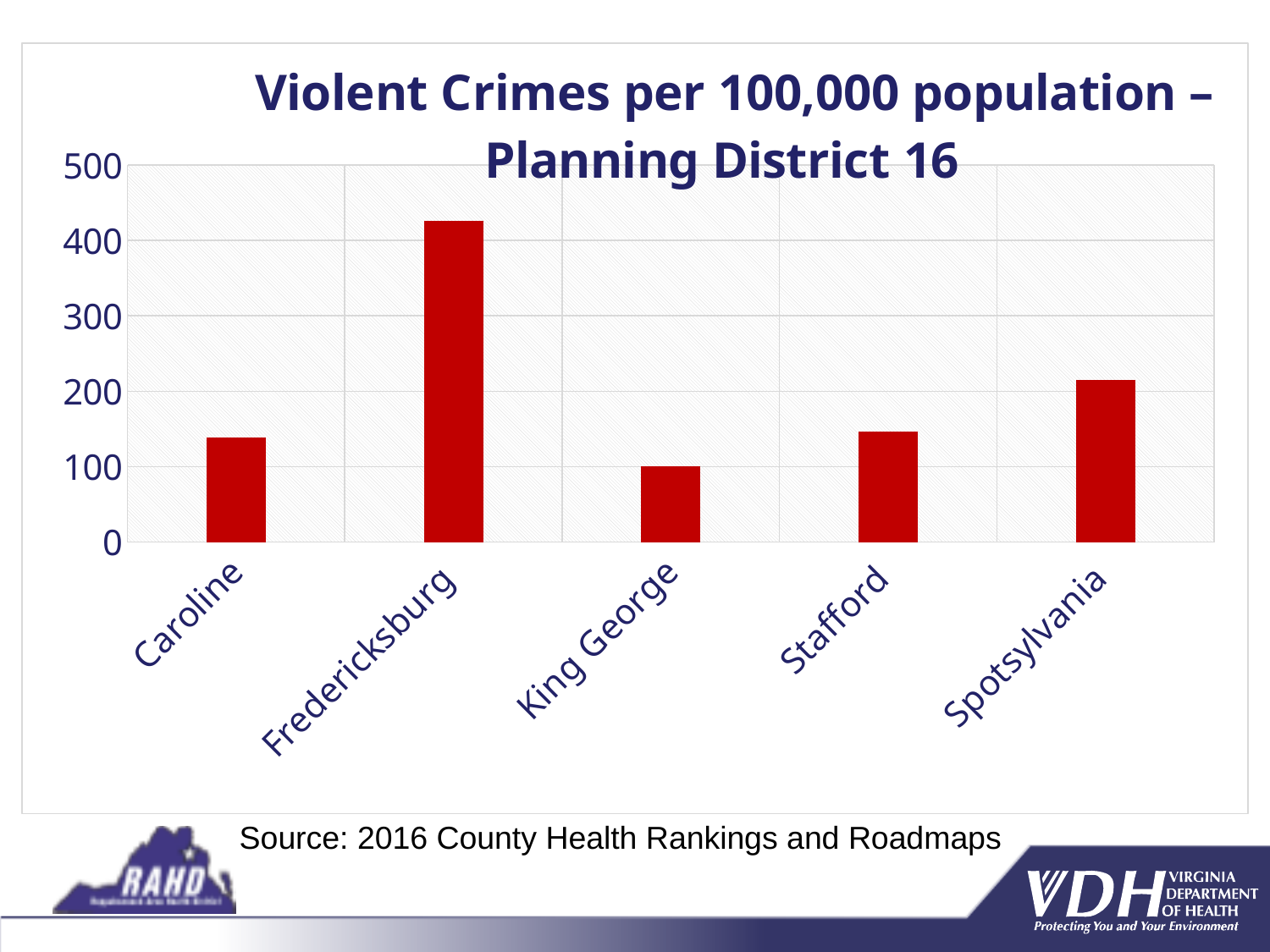
Which locality has the lowest rate of violent crimes per 100,000 population? King George Is the value for Spotsylvania greater or less than 200? greater Which locality has the highest rate of violent crimes per 100,000 population? Fredericksburg What kind of chart is shown on the slide? Bar chart How many localities are shown on the x axis of the chart? 5 Which has a higher violent crime rate, Spotsylvania or Stafford? Spotsylvania Is the value for Caroline greater or less than 200? less Which has a higher violent crime rate, Fredericksburg or Spotsylvania? Fredericksburg Is the value for King George greater or less than 200? less What is the title of the chart? Violent Crimes per 100,000 population – Planning District 16